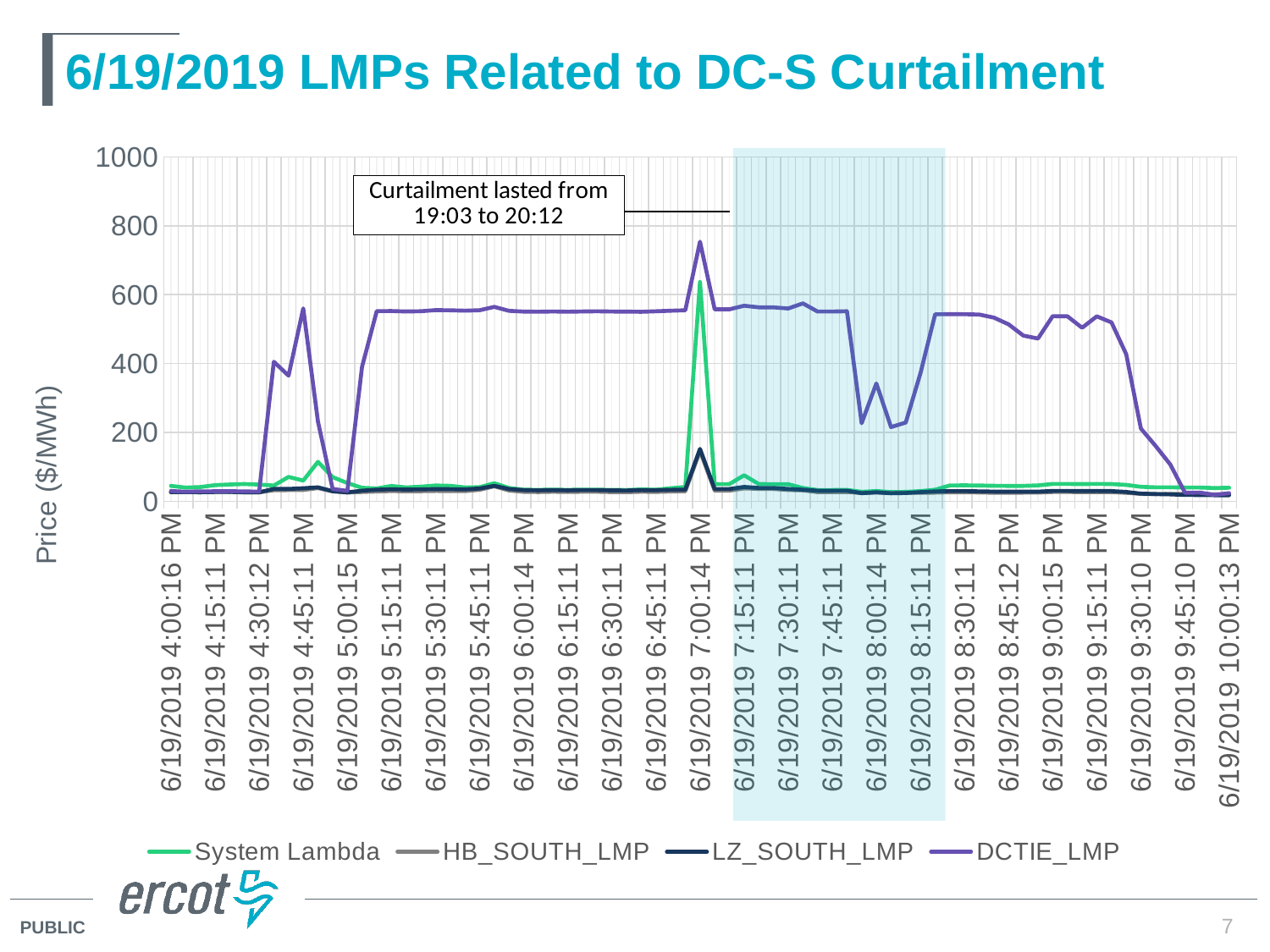
Is the peak value of LZ_SOUTH_LMP near 6/19/2019 7:00:14 PM greater or less than 200? less Is the peak value of DCTIE_LMP near 6/19/2019 7:00:14 PM greater or less than 600? greater What does the text box on the chart say about the curtailment? Curtailment lasted from 19:03 to 20:12 Is the value of DCTIE_LMP at 6/19/2019 6:00:14 PM greater or less than 400? greater How many time labels are shown along the x axis? 25 What kind of chart is shown on the slide? Line chart Which series reaches the highest value on the chart? DCTIE_LMP At 6/19/2019 6:00:14 PM, which series has the larger value, DCTIE_LMP or LZ_SOUTH_LMP? DCTIE_LMP What is the label of the y axis? Price ($/MWh) How many series does the legend list? 4